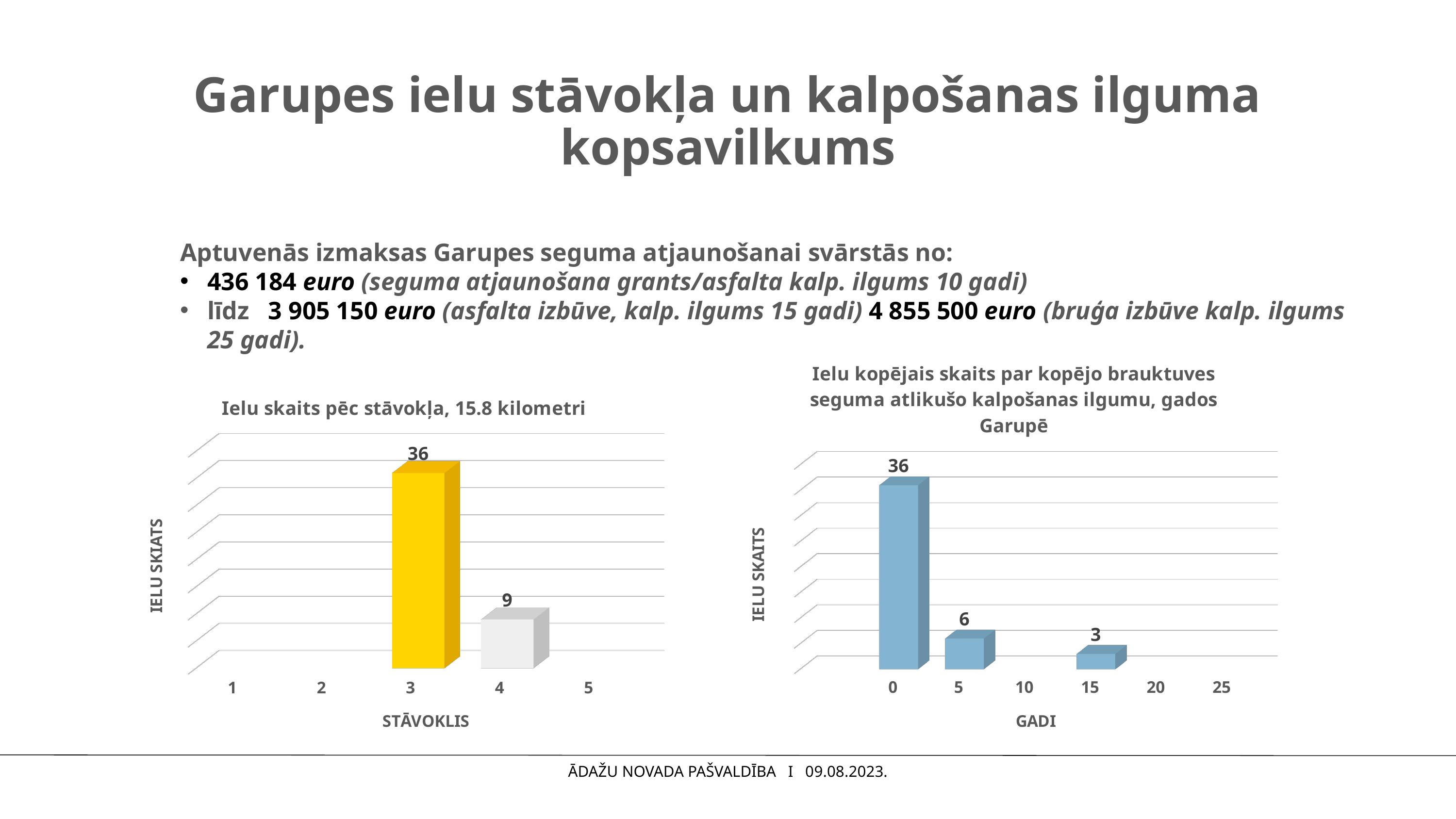
In the right chart 'Ielu kopējais skaits par kopējo brauktuves seguma atlikušo kalpošanas ilgumu, gados Garupē', what is the value for 5 years (gadi)? 6 In the left chart 'Ielu skaits pēc stāvokļa, 15.8 kilometri', what is the difference between the values for condition 3 and condition 4? 27 In the right chart 'Ielu kopējais skaits par kopējo brauktuves seguma atlikušo kalpošanas ilgumu, gados Garupē', what is the difference between the values for 0 years and 5 years? 30 In the right chart 'Ielu kopējais skaits par kopējo brauktuves seguma atlikušo kalpošanas ilgumu, gados Garupē', which is larger: the value for 5 years or the value for 15 years? 5 years How many categories are shown on the x axis of the right chart 'Ielu kopējais skaits par kopējo brauktuves seguma atlikušo kalpošanas ilgumu, gados Garupē'? 6 In the right chart 'Ielu kopējais skaits par kopējo brauktuves seguma atlikušo kalpošanas ilgumu, gados Garupē', what is the value for 15 years (gadi)? 3 In the left chart 'Ielu skaits pēc stāvokļa, 15.8 kilometri', which condition category has the highest value? 3 In the left chart 'Ielu skaits pēc stāvokļa, 15.8 kilometri', what is the value for condition (stāvoklis) 3? 36 In the left chart 'Ielu skaits pēc stāvokļa, 15.8 kilometri', what is the value for condition (stāvoklis) 4? 9 In the right chart 'Ielu kopējais skaits par kopējo brauktuves seguma atlikušo kalpošanas ilgumu, gados Garupē', what is the value for 0 years (gadi)? 36 What is the x-axis title of the right chart 'Ielu kopējais skaits par kopējo brauktuves seguma atlikušo kalpošanas ilgumu, gados Garupē'? GADI What kind of chart is the left chart 'Ielu skaits pēc stāvokļa, 15.8 kilometri'? Bar chart